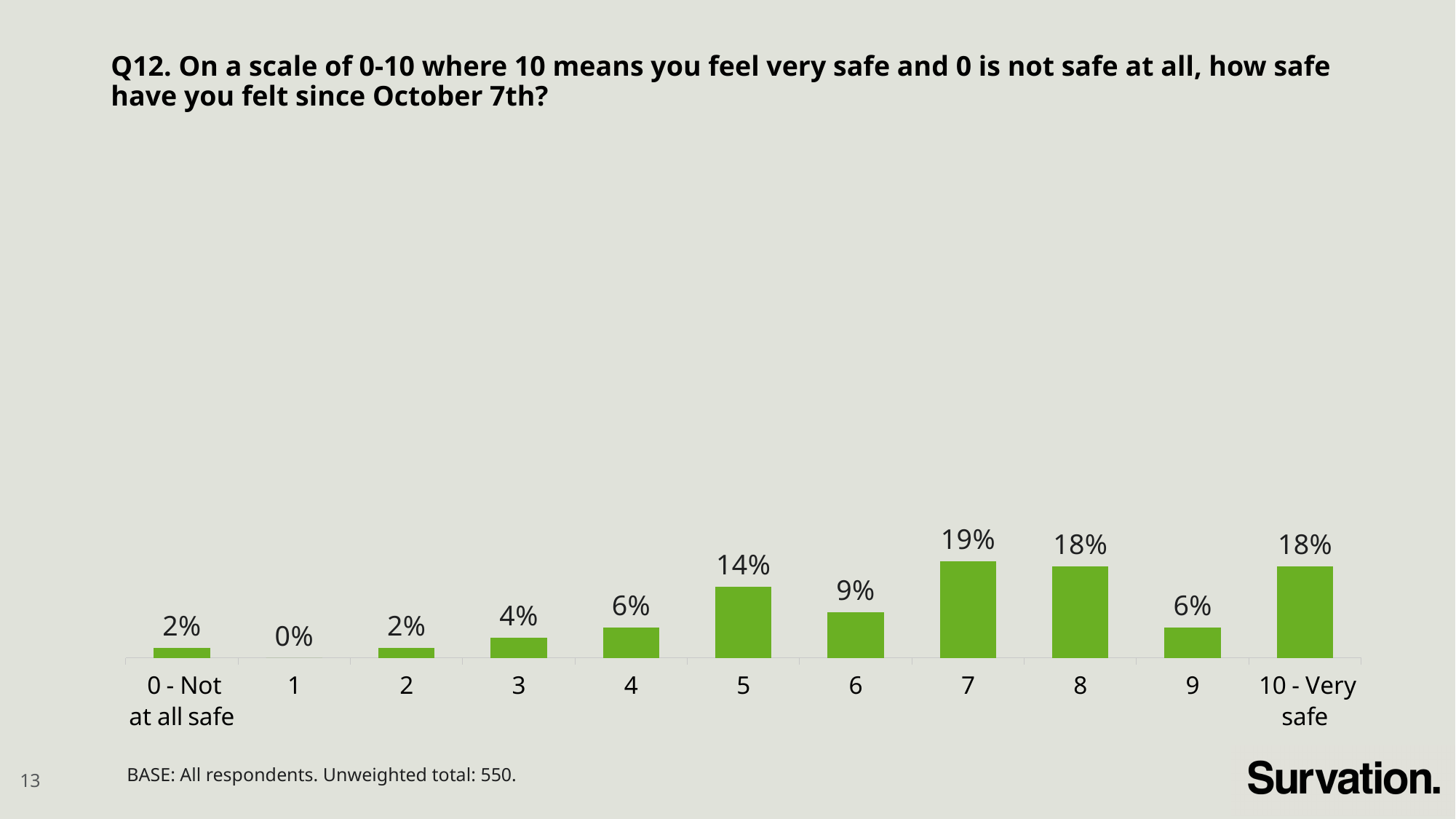
What is the combined percentage for ratings 8 and 9? 24% What kind of chart is shown on the slide? Bar chart What is the difference in percentage points between ratings 7 and 6? 10 How many rating categories are shown on the x axis? 11 What is the unweighted total of respondents stated in the base note? 550 What percentage of respondents gave a rating of 5? 14% What percentage of respondents chose '0 - Not at all safe'? 2% Which rating has the highest percentage of respondents? 7 What percentage of respondents gave a rating of 7? 19% What percentage of respondents chose '10 - Very safe'? 18% Which rating has the lowest percentage of respondents? 1 Which has a larger percentage of respondents, rating 5 or rating 9? 5